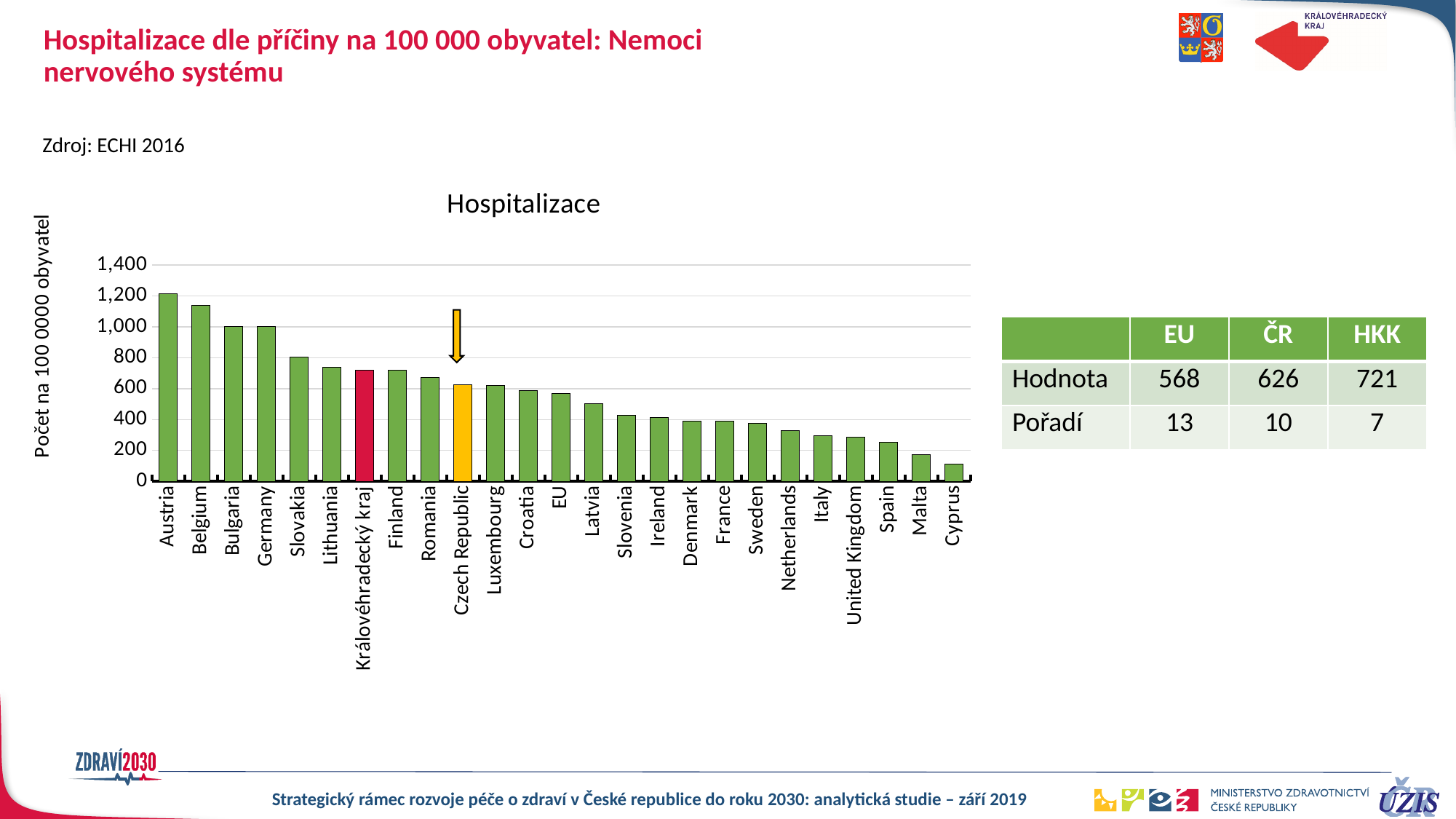
Is the value for Belgium greater or less than 1,000? greater How many categories (bars) are plotted in the chart? 25 What type of chart is shown on the slide? bar chart Is the value for Spain greater or less than 400? less Do the values rise or fall moving from left to right along the x axis? fall What is the hospitalization value for the Czech Republic (ČR) according to the slide? 626 Which has a larger value, Belgium or Bulgaria? Belgium Which category has the highest hospitalization value in the chart? Austria What is the hospitalization value for Královéhradecký kraj (HKK) according to the slide? 721 What is the hospitalization value for the EU according to the slide? 568 Which category has the lowest hospitalization value in the chart? Cyprus What is the difference between the values for Královéhradecký kraj (HKK) and the EU? 153